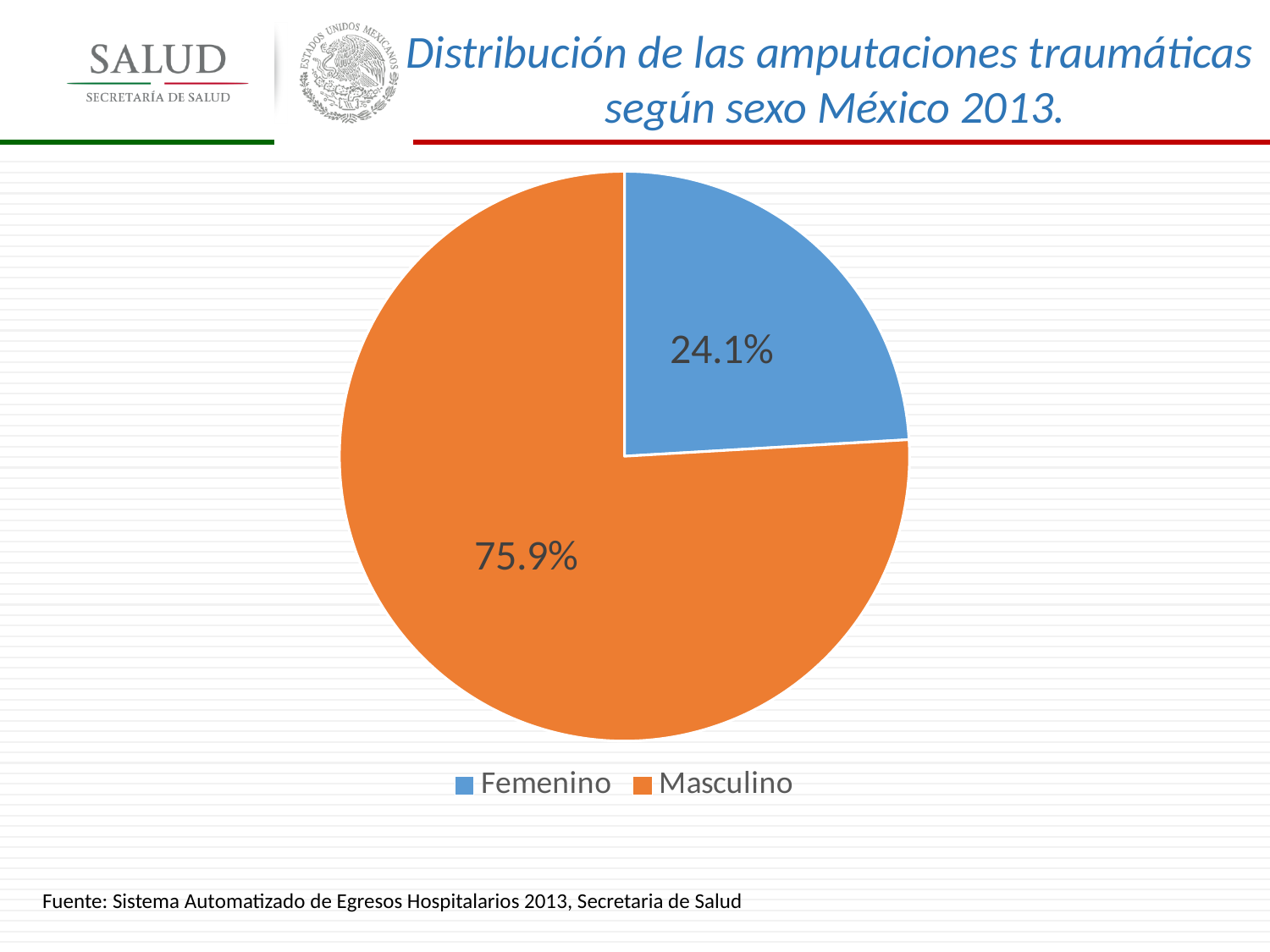
Which category has the largest slice of the pie? Masculino What share of traumatic amputations corresponds to Masculino? 75.9% What type of chart is shown on the slide? Pie chart Which category has the smallest slice of the pie? Femenino How many entries does the legend list? 2 What colour is the Femenino slice? Blue How many categories does the pie chart show? 2 Which slice is larger, Femenino or Masculino? Masculino What share of traumatic amputations corresponds to Femenino? 24.1% What is the difference in percentage points between the Masculino and Femenino slices? 51.8 What is the title of the chart on the slide? Distribución de las amputaciones traumáticas según sexo México 2013.